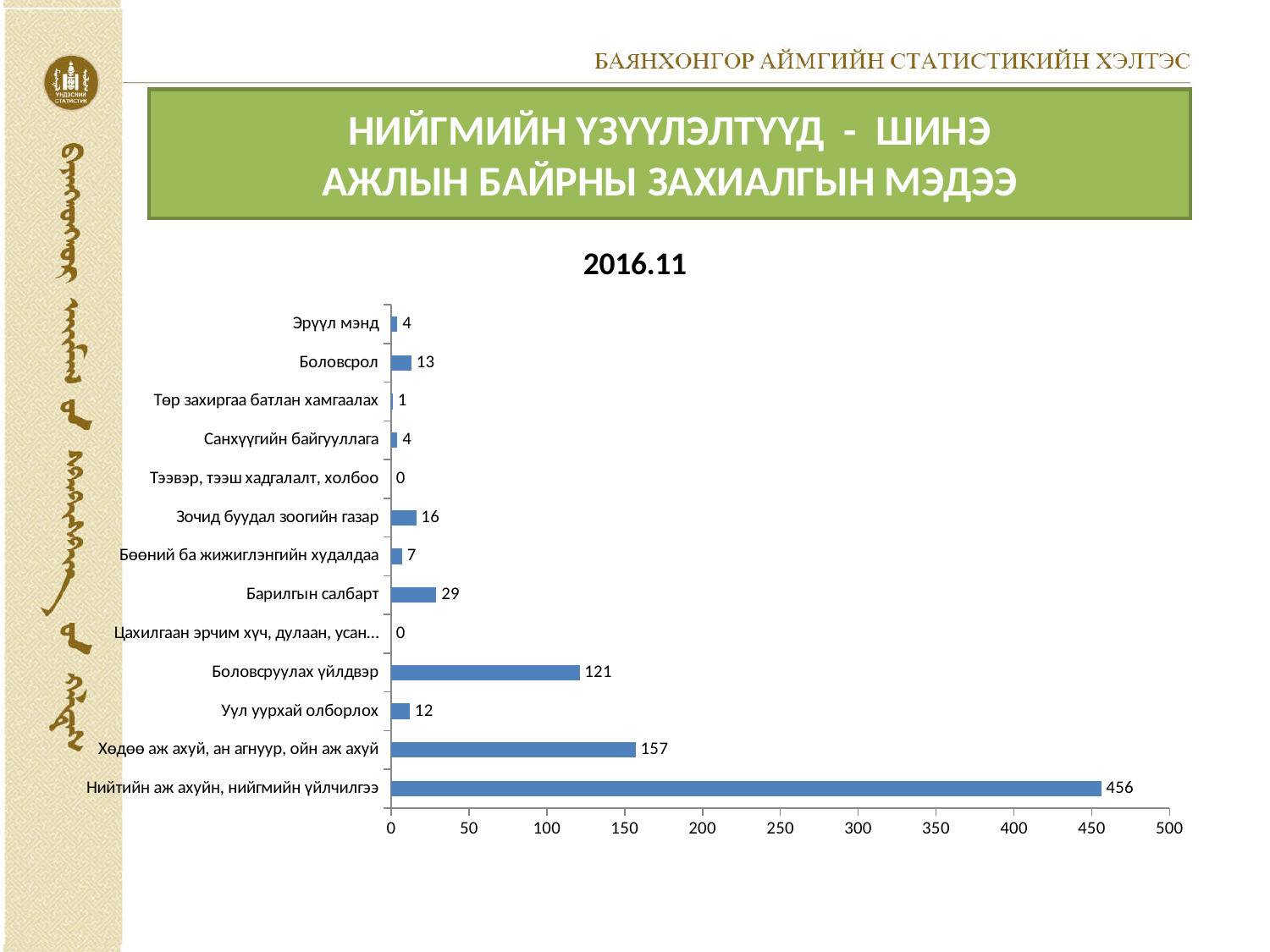
What is the difference between the values for Боловсрол and Уул уурхай олборлох? 1 What is the difference between the values for Хөдөө аж ахуй, ан агнуур, ойн аж ахуй and Боловсруулах үйлдвэр? 36 What is the title of the chart? 2016.11 What kind of chart is shown on the slide? bar chart What is the value for Барилгын салбарт? 29 What is the value for Боловсруулах үйлдвэр? 121 Is the value for Хөдөө аж ахуй, ан агнуур, ойн аж ахуй greater or less than 150? greater How many categories are shown in the chart? 13 What is the value for Зочид буудал зоогийн газар? 16 Which category has the highest value? Нийтийн аж ахуйн, нийгмийн үйлчилгээ What is the value for Нийтийн аж ахуйн, нийгмийн үйлчилгээ? 456 Which is larger, the value for Барилгын салбарт or the value for Зочид буудал зоогийн газар? Барилгын салбарт